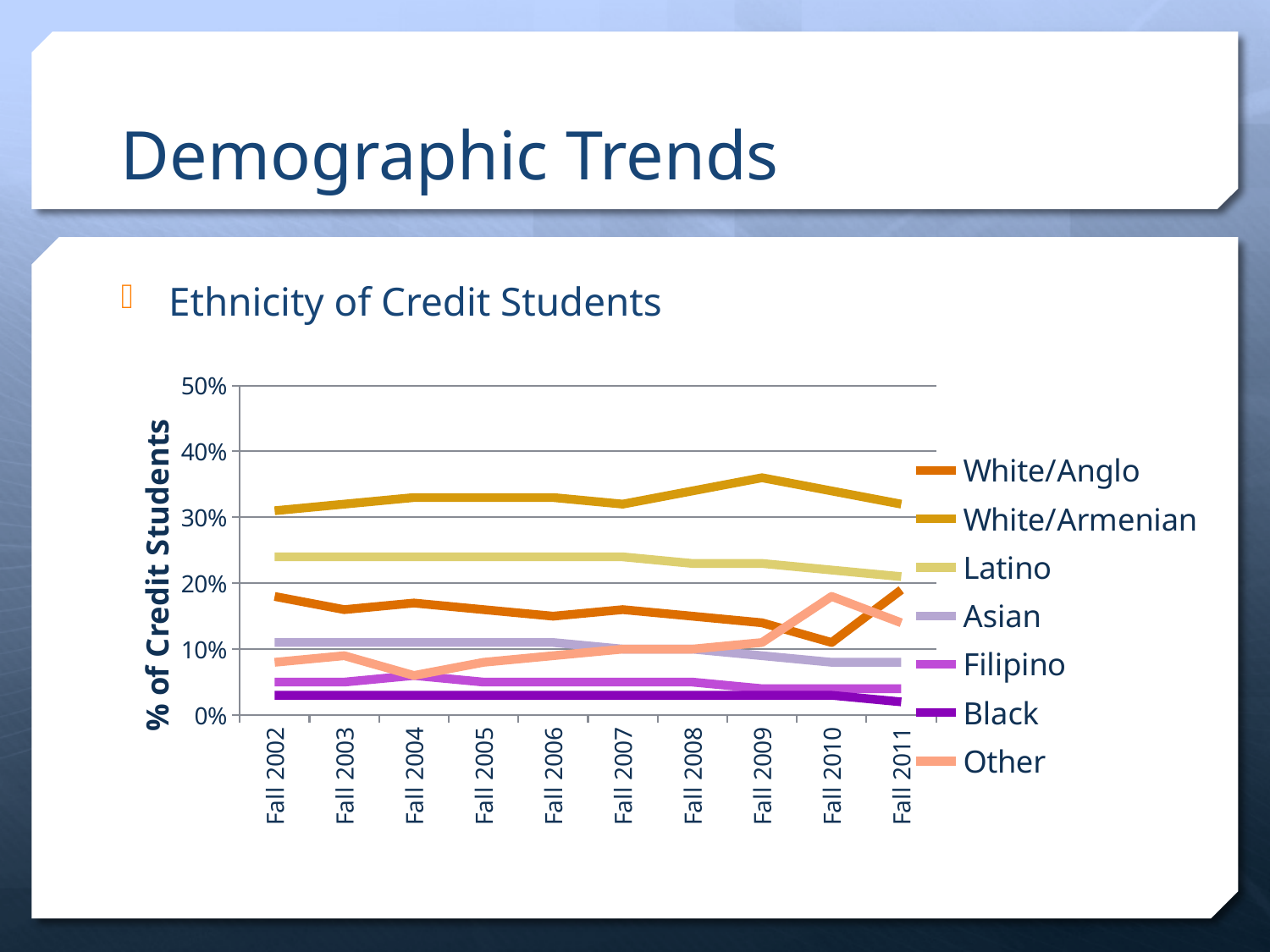
How many series does the legend list? 7 Is the value for White/Armenian in Fall 2009 greater or less than 30%? greater In Fall 2004, which is larger: the value for Asian or the value for Other? Asian Is the value for Latino in Fall 2002 greater or less than 20%? greater Which ethnicity has the lowest percentage of credit students in Fall 2011? Black Is the value for White/Anglo in Fall 2010 greater or less than 20%? less How many Fall terms are plotted along the x axis? 10 What kind of chart is shown on the slide? line chart What is the title of the y axis? % of Credit Students In Fall 2011, which is larger: the value for White/Anglo or the value for Other? White/Anglo Does the Latino line rise or fall from Fall 2007 to Fall 2011? fall Which ethnicity has the highest percentage of credit students in Fall 2009? White/Armenian